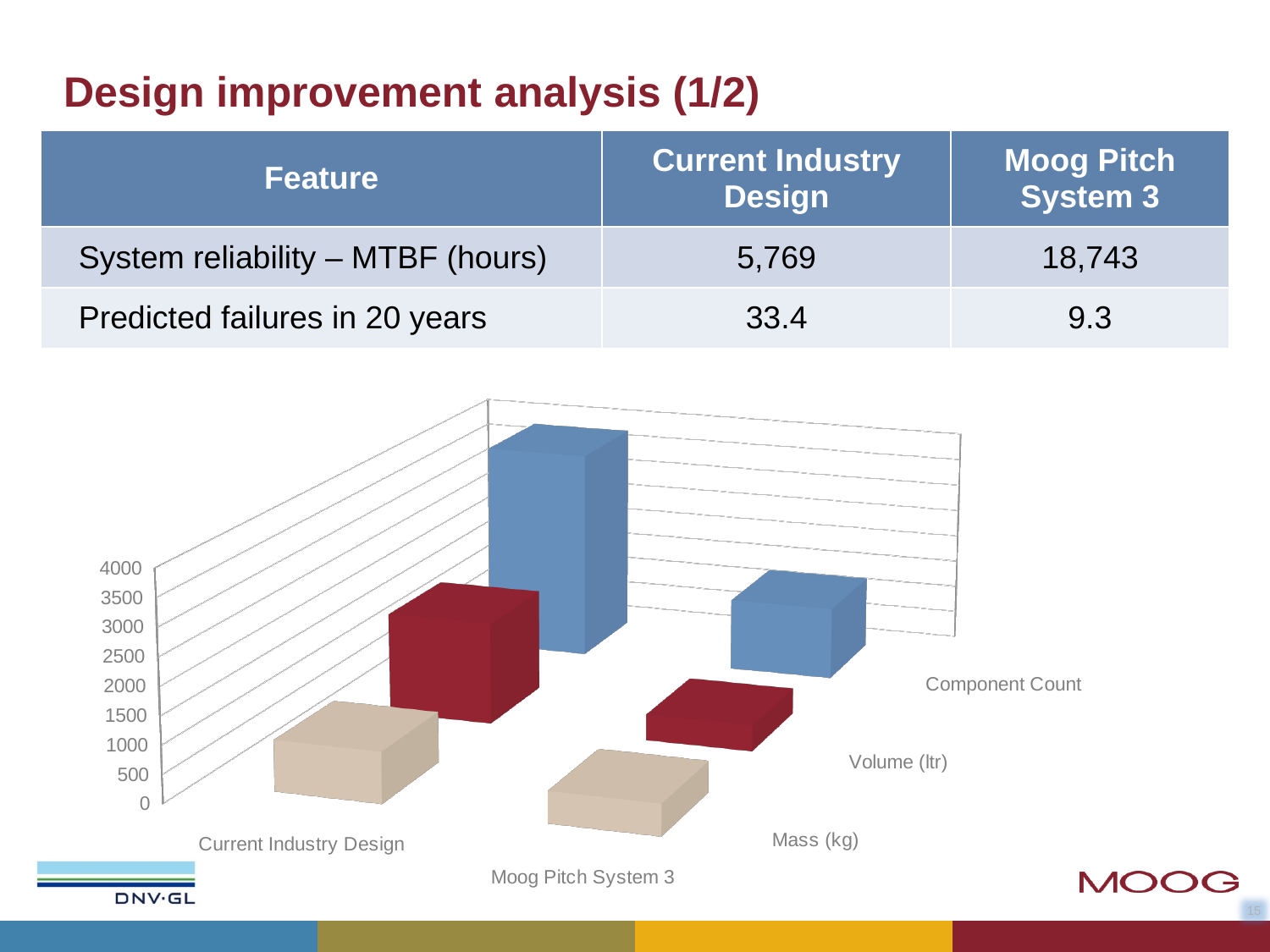
Is the Mass (kg) for Current Industry Design greater or less than 2000? less How many series does the chart show? 3 Which design has the larger Volume (ltr), Current Industry Design or Moog Pitch System 3? Current Industry Design Which design has the larger Component Count, Current Industry Design or Moog Pitch System 3? Current Industry Design Which series has the highest value for Current Industry Design? Component Count Do the values rise or fall going from Current Industry Design to Moog Pitch System 3? fall How many design categories are plotted on the chart? 2 Is the Component Count for Current Industry Design greater or less than 2000? greater Which design has the larger Mass (kg), Current Industry Design or Moog Pitch System 3? Current Industry Design What is the highest value labelled on the vertical axis of the chart? 4000 What kind of chart is shown on the slide? bar chart Which series has the lowest value for Current Industry Design? Mass (kg)